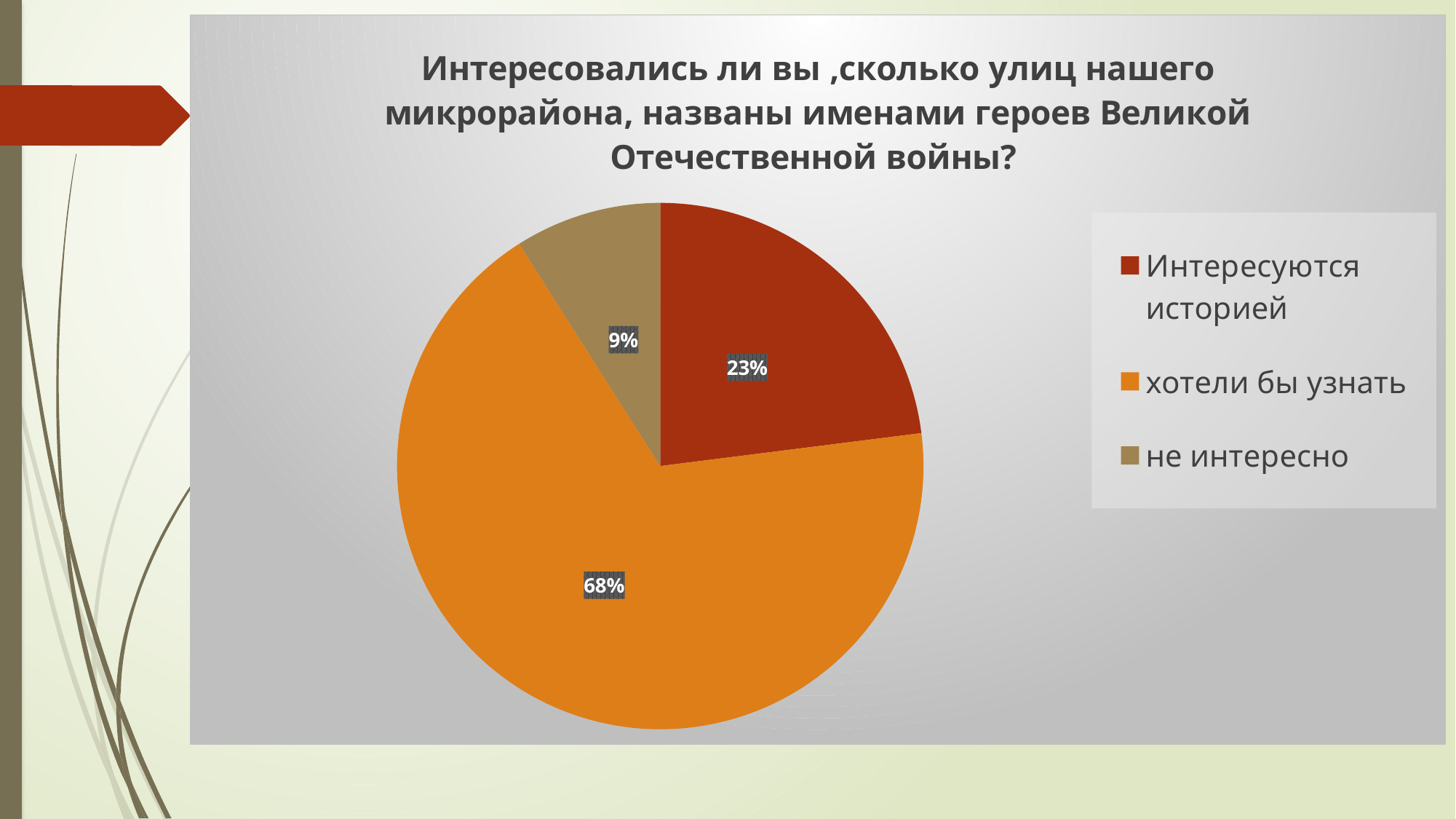
What percentage of respondents are in the "не интересно" category? 9% What percentage of respondents are in the "хотели бы узнать" category? 68% What colour is the slice for "хотели бы узнать"? orange Which category has the largest share of the pie? хотели бы узнать What type of chart is shown on the slide? pie chart What is the difference in percentage points between "хотели бы узнать" and "Интересуются историей"? 45 Which is larger: the share for "Интересуются историей" or the share for "не интересно"? Интересуются историей Which category has the smallest share of the pie? не интересно How many categories does the pie chart have? 3 What percentage of respondents are in the "Интересуются историей" category? 23% Which legend entry is listed first? Интересуются историей What is the difference in percentage points between "Интересуются историей" and "не интересно"? 14